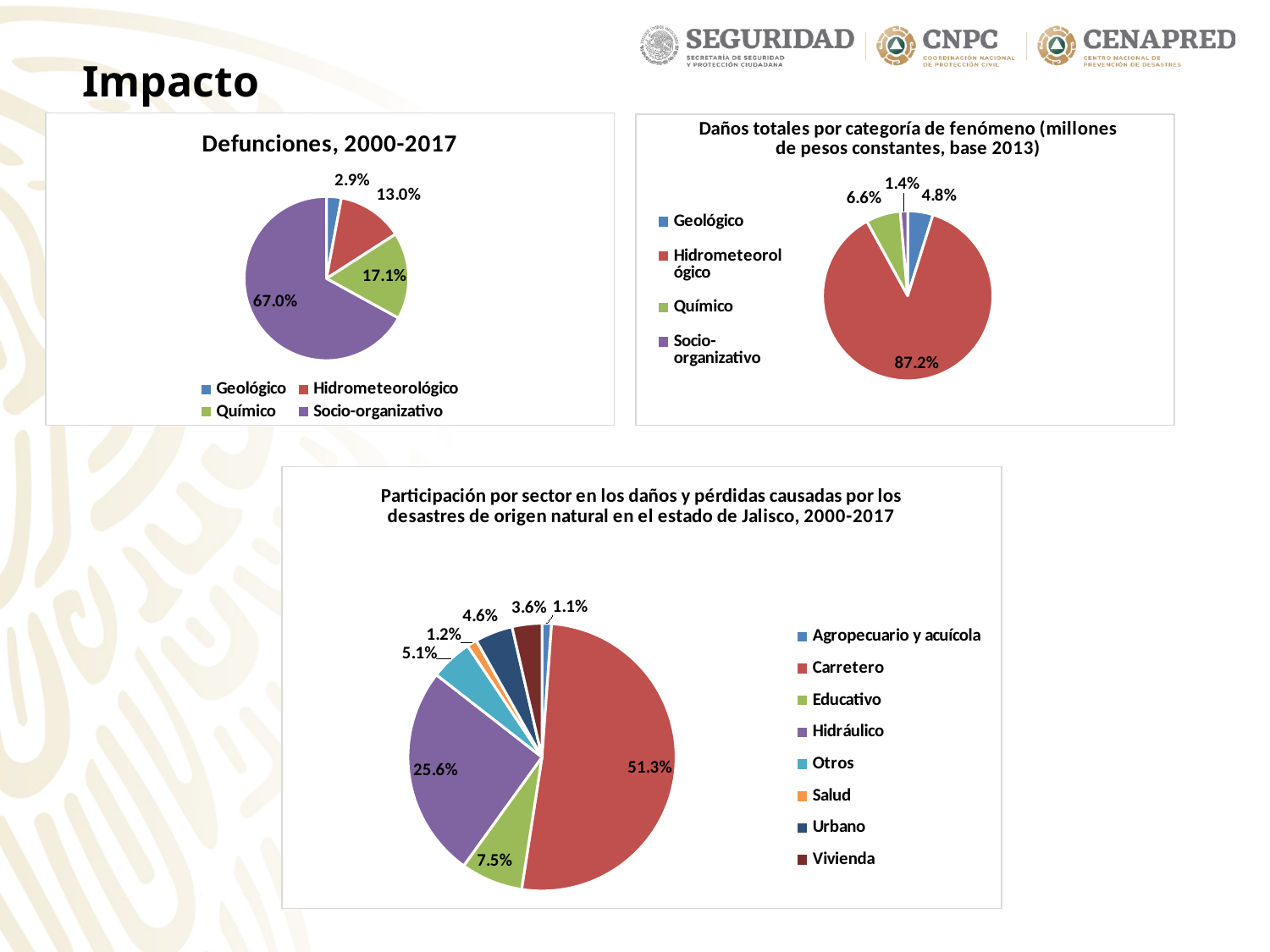
In the 'Participación por sector' chart, what share is Carretero? 51.3% In the 'Defunciones, 2000-2017' chart, which category has the smallest share? Geológico In the 'Defunciones, 2000-2017' chart, what share is Socio-organizativo? 67.0% In the 'Daños totales por categoría de fenómeno' chart, what share is Hidrometeorológico? 87.2% In the 'Participación por sector' chart, what is the difference between the Carretero and Hidráulico shares? 25.7% In the 'Daños totales por categoría de fenómeno' chart, which category has the smallest share? Socio-organizativo What type of chart is the 'Defunciones, 2000-2017' chart? Pie chart In the 'Defunciones, 2000-2017' chart, what is the difference between the Químico and Hidrometeorológico shares? 4.1% In the 'Daños totales por categoría de fenómeno' chart, which is larger, Geológico or Químico? Químico In the 'Participación por sector' chart, how many sectors does the legend list? 8